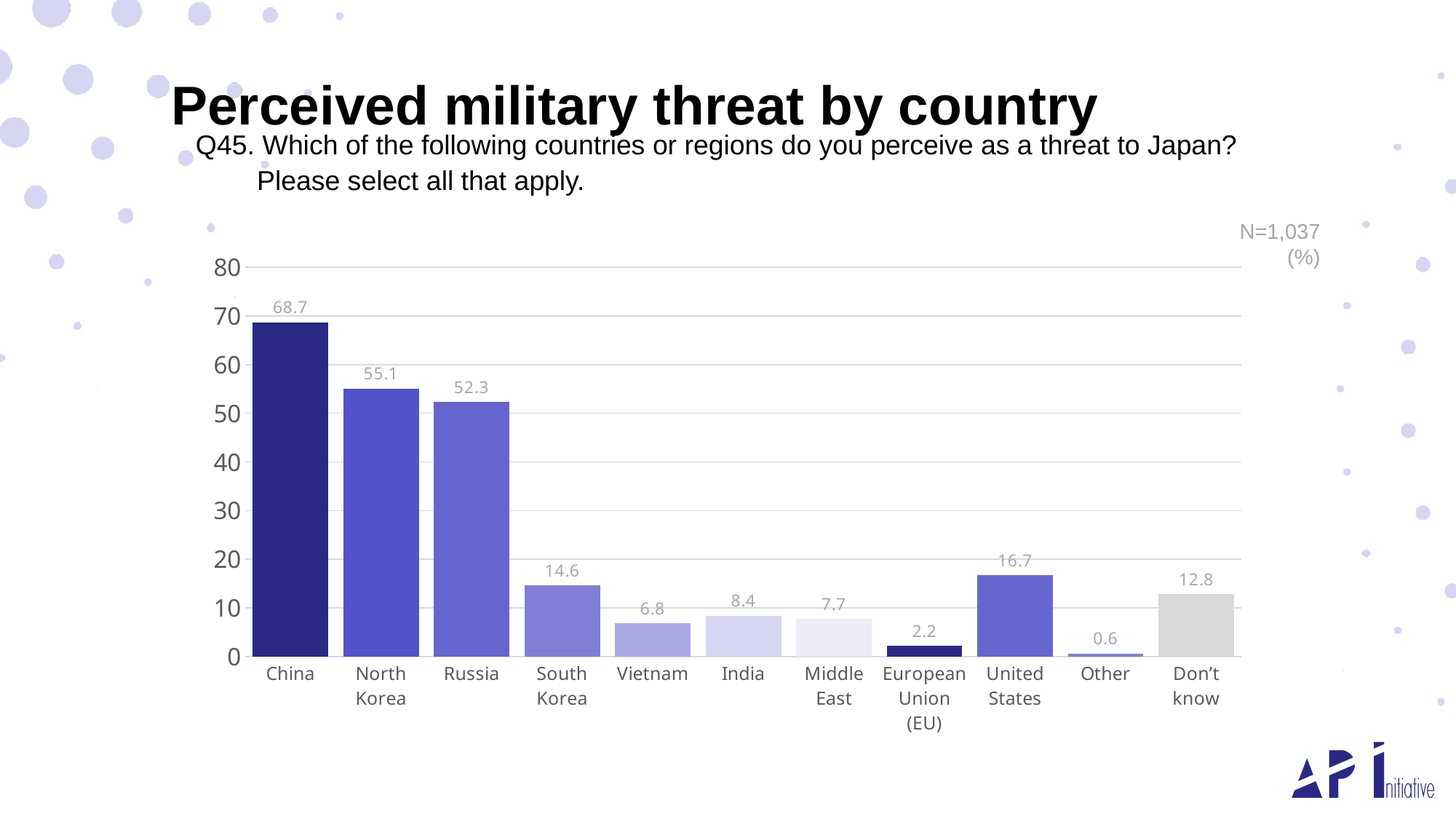
What is the sample size (N) shown on the chart? N=1,037 How many categories are shown on the x axis? 11 Which is larger, the value for India or the value for Vietnam? India Is the value for South Korea greater or less than 20? less What is the value for Don't know? 12.8 What is the difference between the values for China and Russia? 16.4 What is the value for North Korea? 55.1 Which category has the lowest value? Other Which country or region has the highest value? China What is the value for the United States? 16.7 What is the value for China? 68.7 What kind of chart is shown on the slide? bar chart